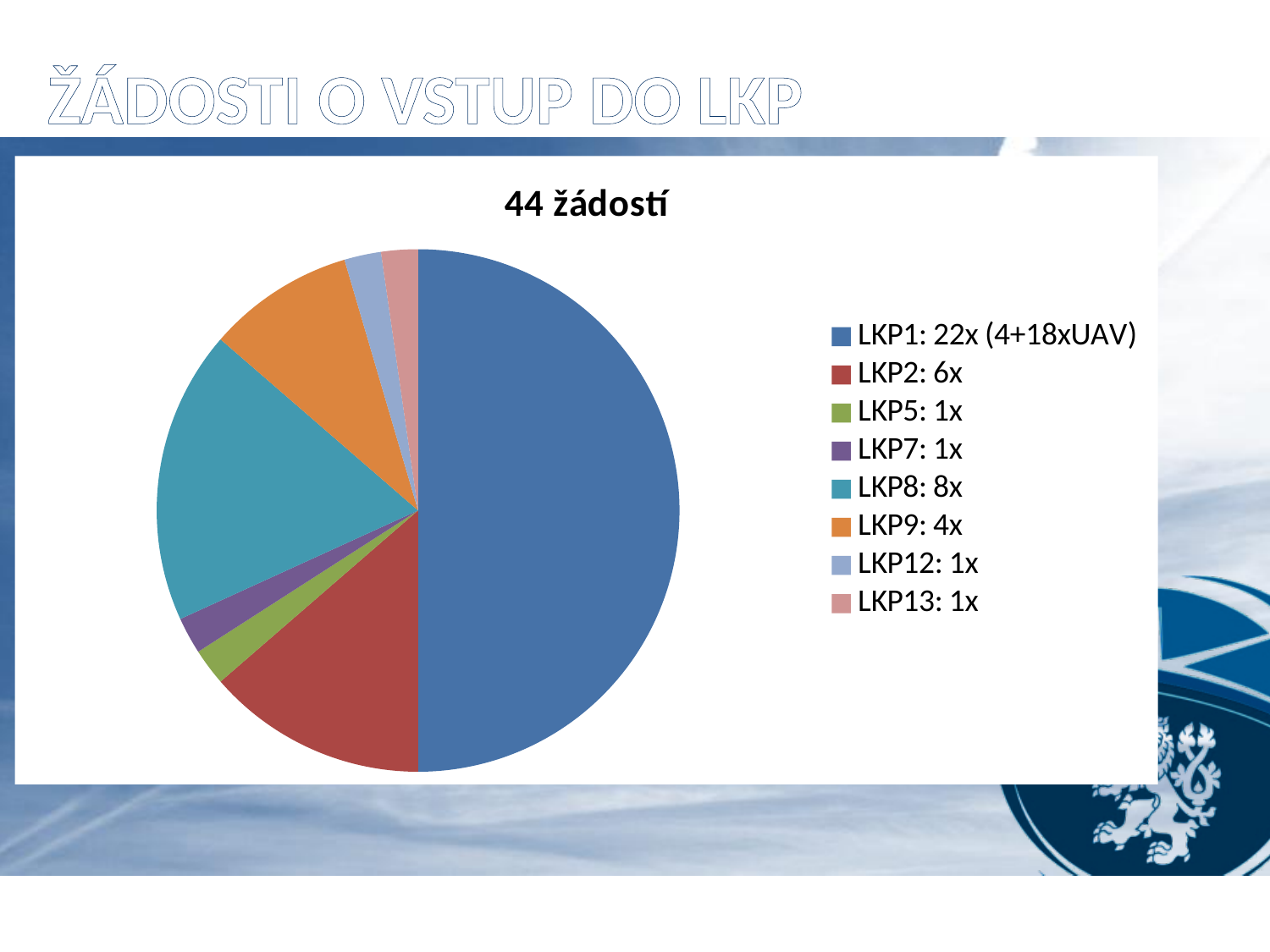
What share of the pie does LKP1 represent? 50% What is the title of the chart? 44 žádostí Which category has more requests, LKP8 or LKP2? LKP8 What is the total number of requests across all slices of the pie? 44 Which category has the largest slice of the pie? LKP1 How many requests does the legend give for LKP9? 4x How many requests does the legend give for LKP2? 6x What is the difference between the number of requests for LKP1 and LKP8? 14 How many requests does the legend give for LKP8? 8x How many categories does the pie chart's legend list? 8 What colour is the slice for LKP9? orange What kind of chart is shown on the slide? pie chart